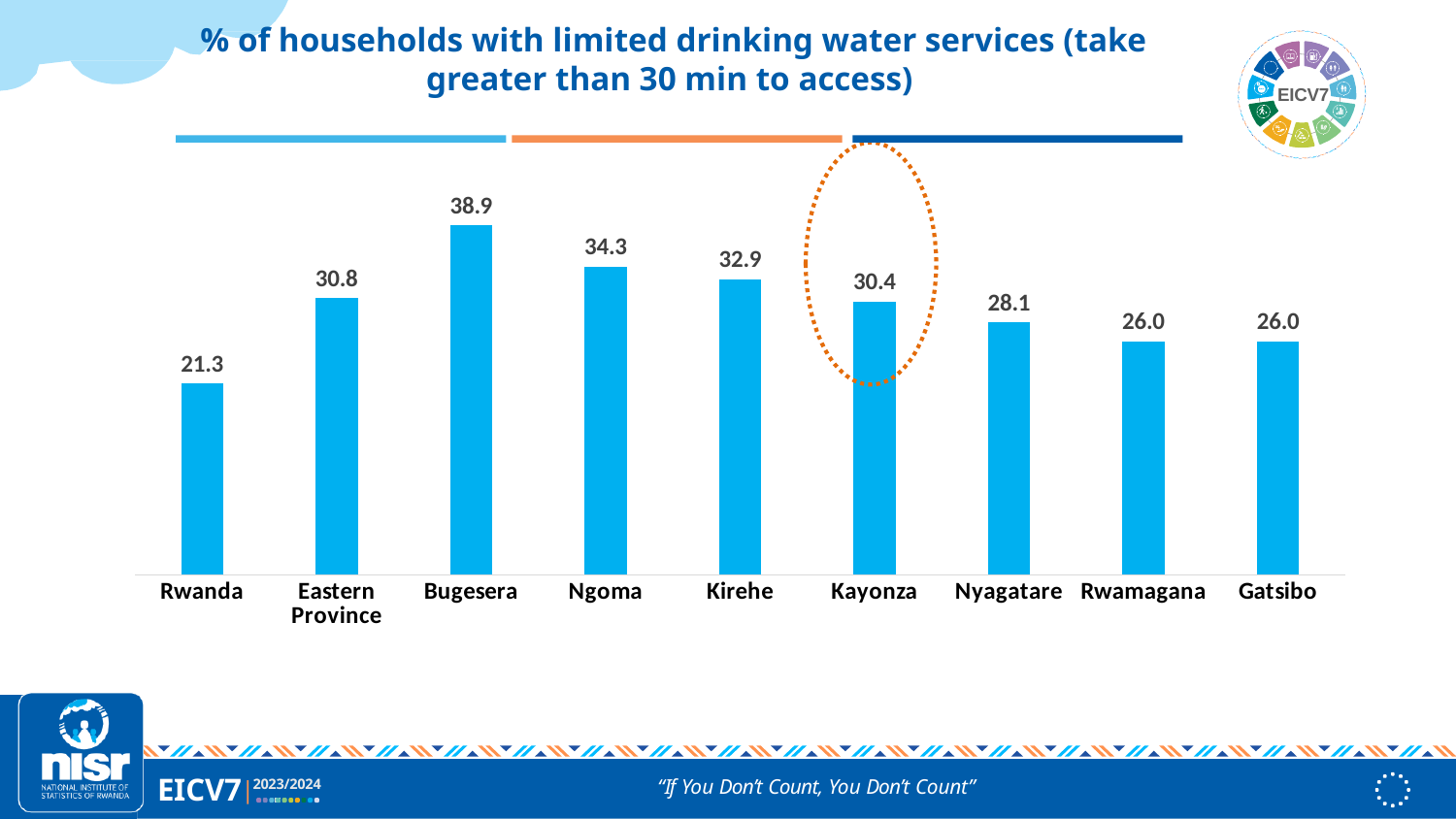
What is the difference between the values for Ngoma and Nyagatare? 6.2 What is the value for Kayonza? 30.4 What is the value for Rwanda? 21.3 Which is larger, the value for Kirehe or the value for Eastern Province? Kirehe What kind of chart is shown on the slide? bar chart Which category is highlighted with a dotted orange circle? Kayonza Which two categories share the same value of 26.0? Rwamagana and Gatsibo What is the difference between the values for Bugesera and Rwanda? 17.6 Which category has the lowest value? Rwanda What is the value for Bugesera? 38.9 How many categories are shown on the x axis? 9 Which category has the highest value? Bugesera